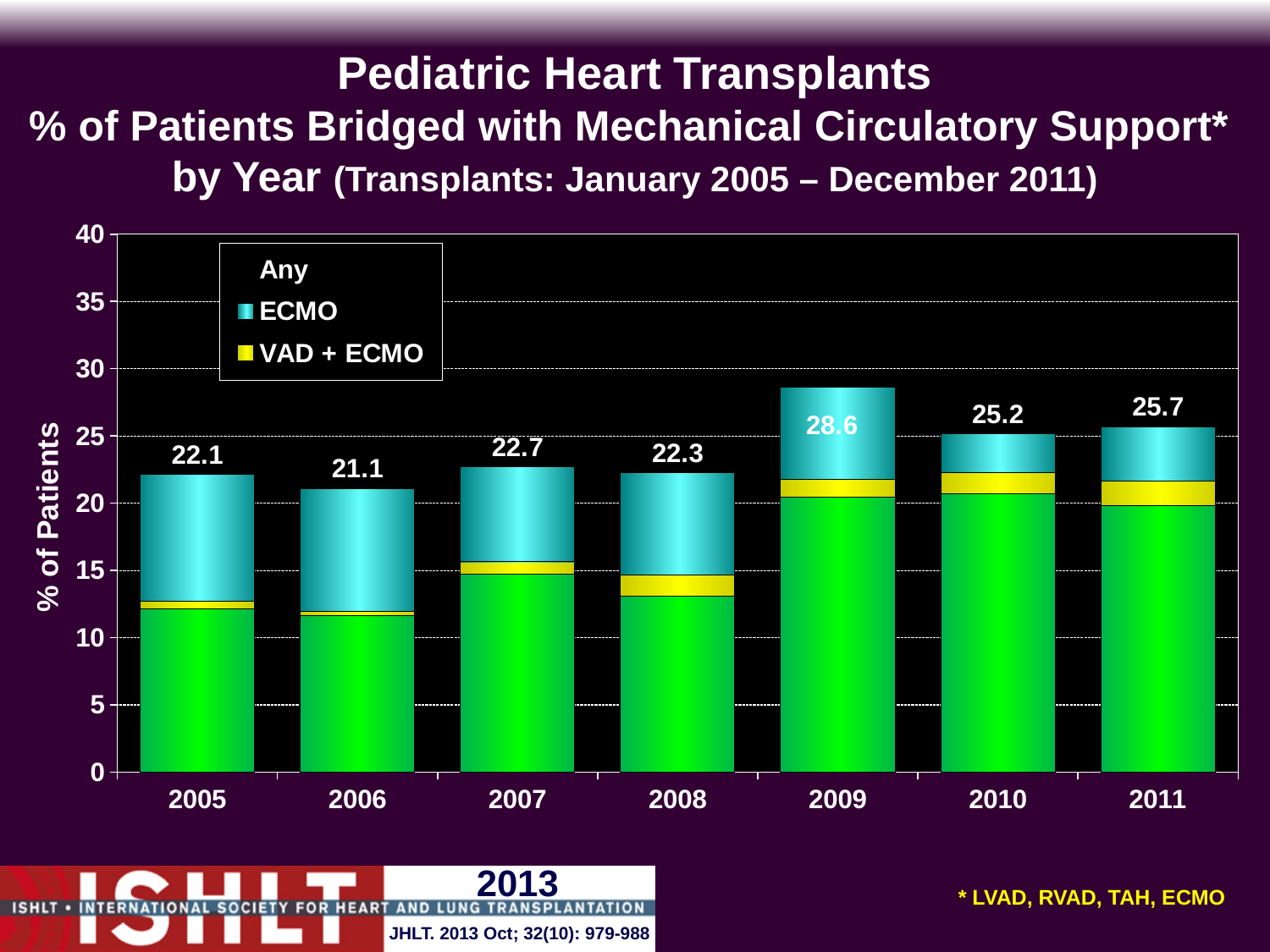
What is the total percentage of patients bridged with mechanical circulatory support in 2009? 28.6 What is the difference between the values for 2011 and 2010? 0.5 How many series does the legend list? 3 What is the difference between the values for 2009 and 2006? 7.5 What is the value shown for 2011? 25.7 How many years are shown on the x axis? 7 Which year has the lowest percentage of patients bridged with mechanical circulatory support? 2006 What kind of chart is shown on the slide? Stacked bar chart Which year has a larger value, 2007 or 2008? 2007 Is the green (Any) segment for 2005 greater or less than 10? greater Which year has the highest percentage of patients bridged with mechanical circulatory support? 2009 What is the value shown for 2005? 22.1